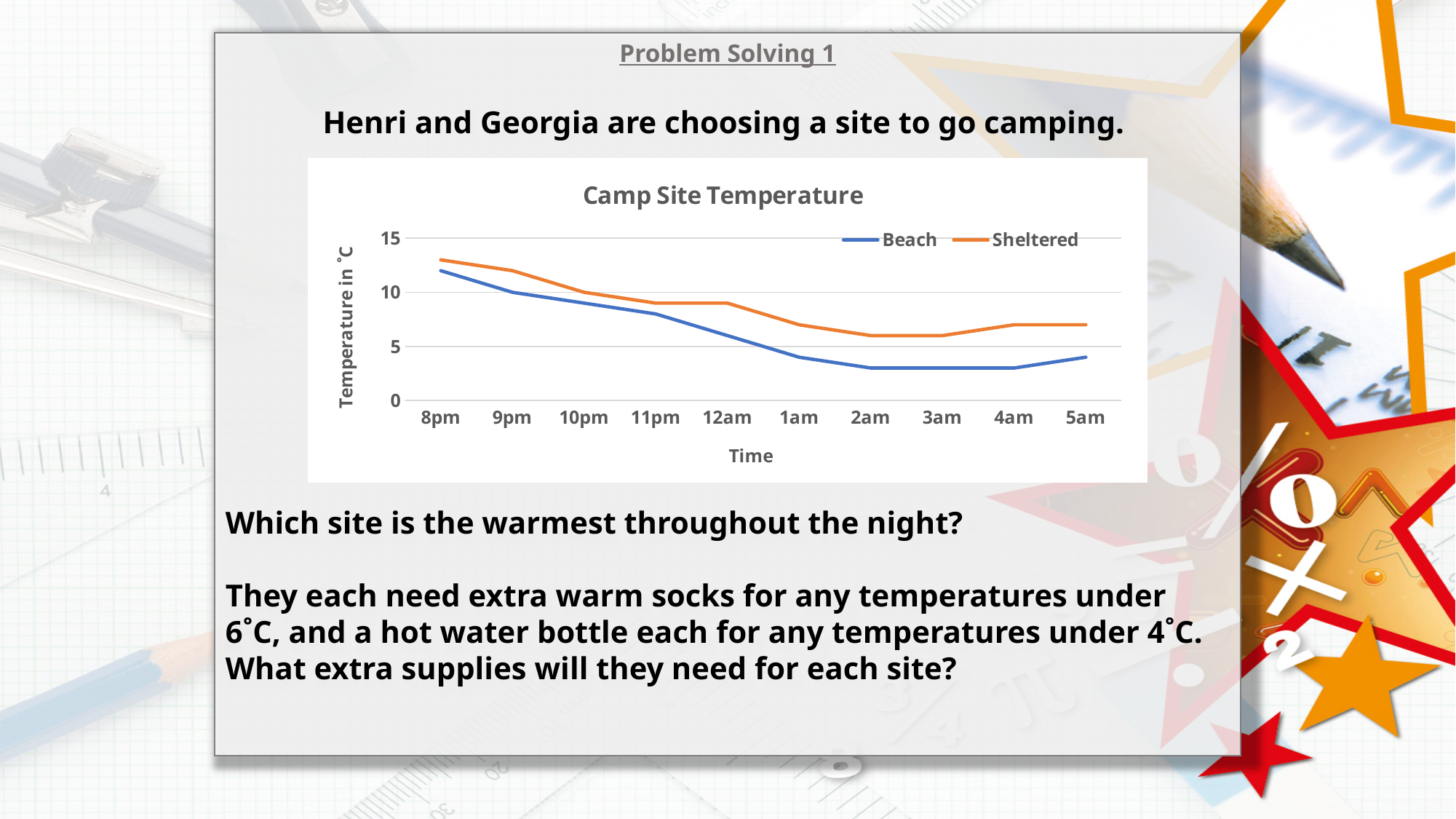
What is the label of the vertical axis of the chart? Temperature in °C What is the title of the chart? Camp Site Temperature Is the Beach temperature at 2am greater or less than 5? less Is the Sheltered temperature at 12am greater or less than 5? greater How many series does the legend of the chart list? 2 Is the Sheltered temperature at 5am greater or less than 10? less What kind of chart is shown on the slide? line chart At what time is the Beach temperature highest? 8pm Does the Beach temperature rise or fall from 8pm to 2am? fall How many time points are plotted along the x axis of the chart? 10 At 8pm, which site has the higher temperature, Beach or Sheltered? Sheltered